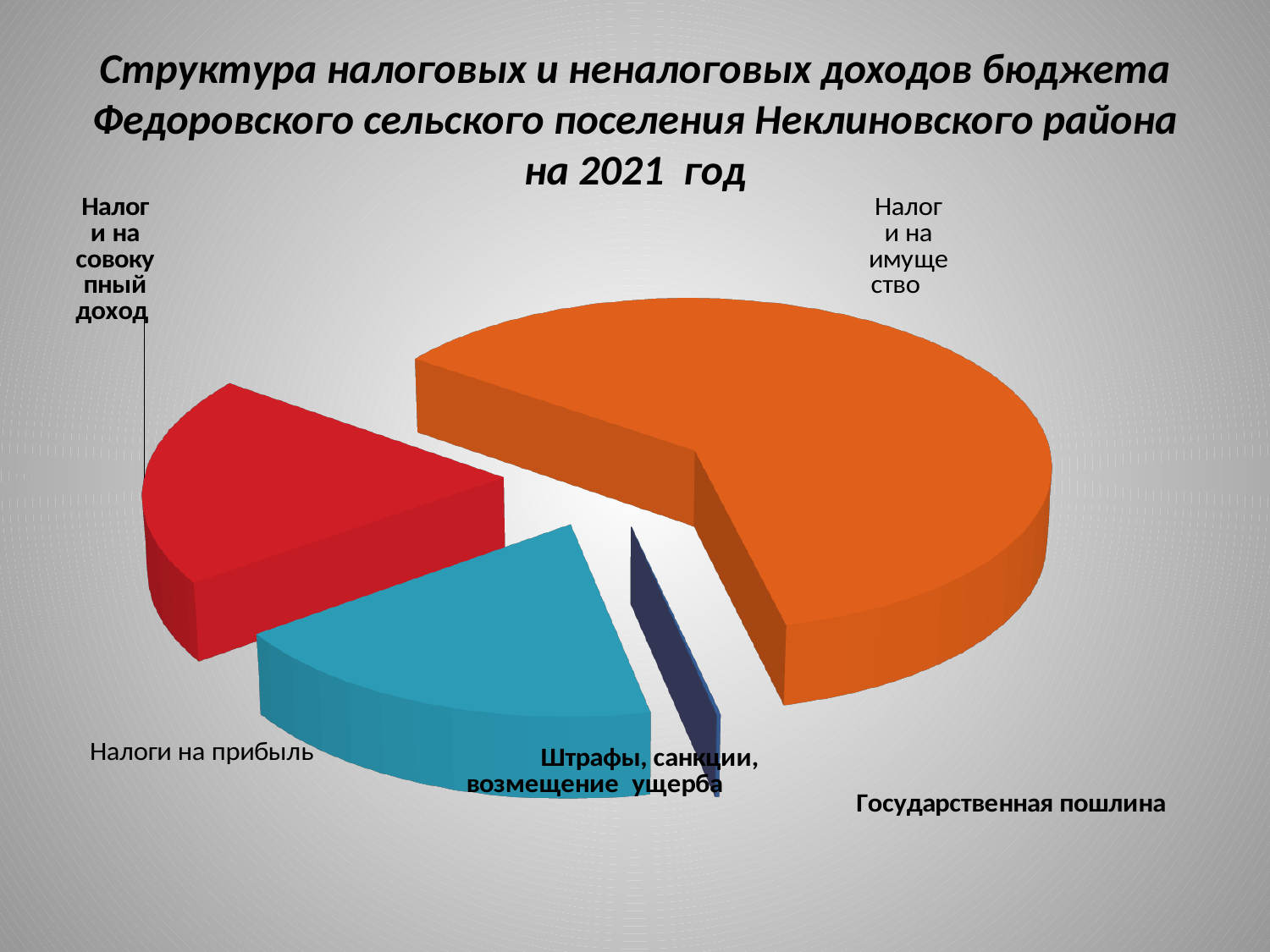
Which is larger: the slice for Налог на имущество or the slice for Налоги на прибыль? Налог на имущество What colour is the slice for Налог на имущество? orange Which is larger: the slice for Налоги на совокупный доход or the slice for Штрафы, санкции, возмещение ущерба? Налоги на совокупный доход How many categories are labelled on the pie chart? 5 Which category has the largest slice of the pie? Налог на имущество Which is larger: the slice for Налог на имущество or the slice for Налоги на совокупный доход? Налог на имущество What kind of chart is shown on the slide? pie chart Which year does the chart title say the budget income structure refers to? 2021